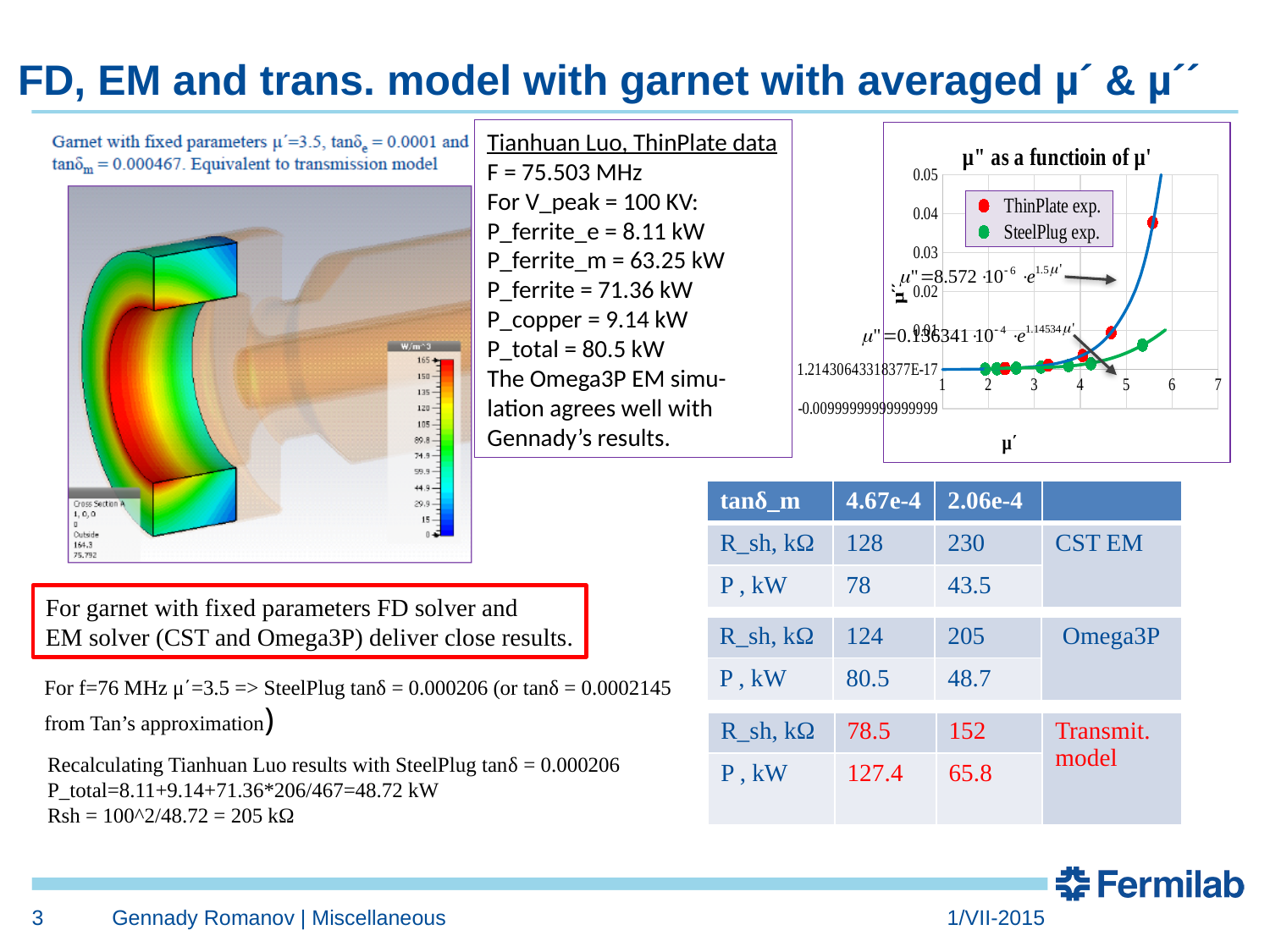
In the "μ" as a functioin of μ'" chart, is the SteelPlug exp. value at μ' of about 5.5 greater or less than 0.02? less How many series does the legend of the "μ" as a functioin of μ'" chart list? 2 In the "μ" as a functioin of μ'" chart, which series reaches the highest μ" value? ThinPlate exp. What are the two series named in the legend of the "μ" as a functioin of μ'" chart? ThinPlate exp. and SteelPlug exp. In the "μ" as a functioin of μ'" chart, at μ' of about 5.5, which series has the larger μ" value, ThinPlate exp. or SteelPlug exp.? ThinPlate exp. What is the largest tick value shown on the x axis of the "μ" as a functioin of μ'" chart? 7 In the "μ" as a functioin of μ'" chart, do the ThinPlate exp. values rise or fall as μ' increases? rise In the "μ" as a functioin of μ'" chart, is the ThinPlate exp. value at μ' of about 5.5 greater or less than 0.03? greater What kind of chart is shown in the "μ" as a functioin of μ'" chart? scatter chart In the "μ" as a functioin of μ'" chart, which colour marks the SteelPlug exp. series? green